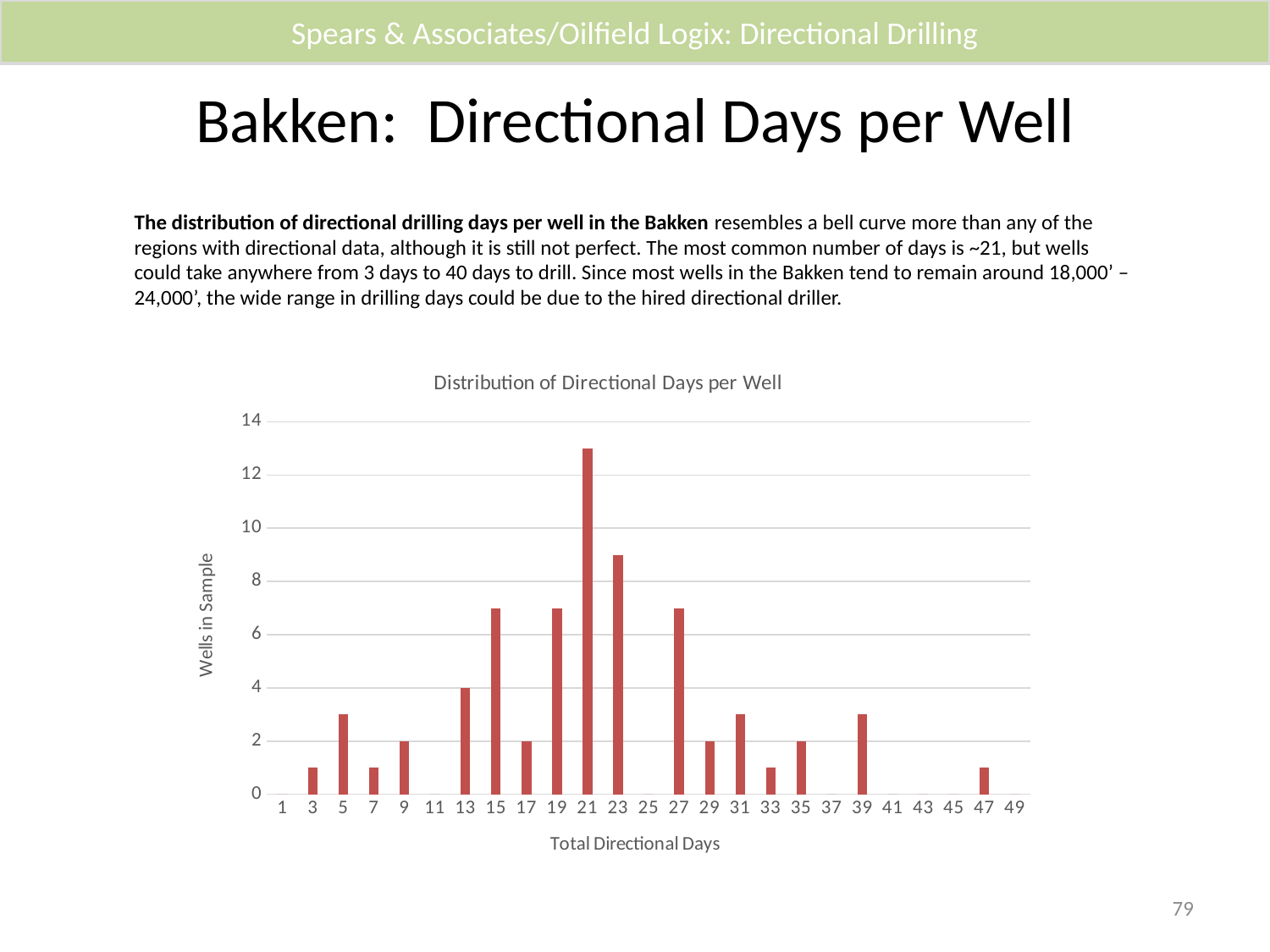
How many wells in sample are shown for 9 total directional days? 2 Is the value for 21 total directional days greater or less than 12? greater Which total directional days value has the highest number of wells in sample? 21 How many wells in sample are shown for 35 total directional days? 2 Is the value for 23 total directional days greater or less than 10? less Is the value for 15 total directional days greater or less than 6? greater Which has more wells in sample: 21 total directional days or 23 total directional days? 21 What is the title of the chart? Distribution of Directional Days per Well What type of chart is shown on the slide? Bar chart What is the label of the y axis? Wells in Sample How many bars are plotted in the chart? 17 How many wells in sample are shown for 13 total directional days? 4